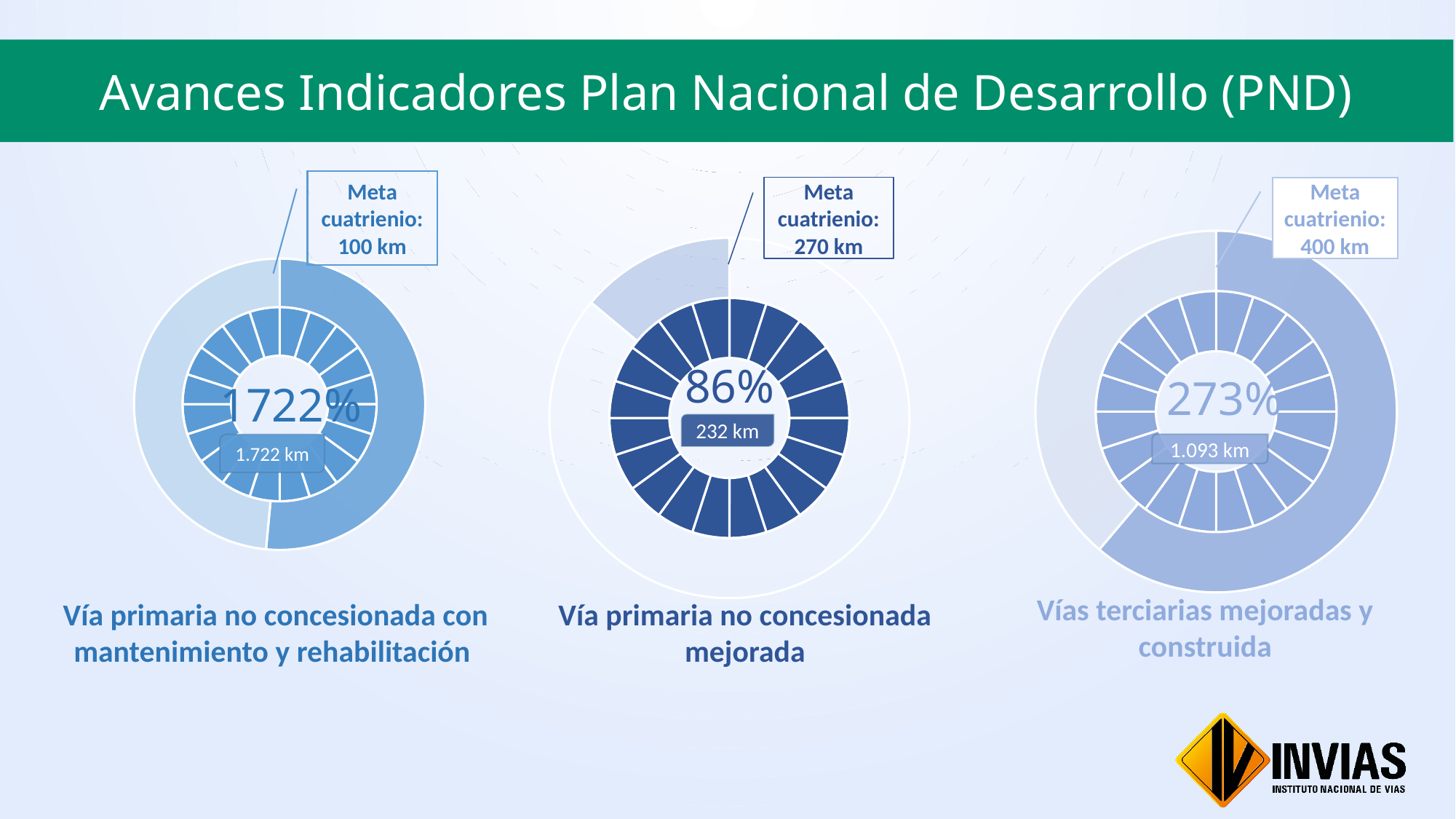
Which of the three indicators has the highest percentage of progress? Vía primaria no concesionada con mantenimiento y rehabilitación What percentage is shown in the centre of the chart for 'Vías terciarias mejoradas y construida'? 273% What is the title of the slide? Avances Indicadores Plan Nacional de Desarrollo (PND) What percentage is shown in the centre of the chart for 'Vía primaria no concesionada mejorada'? 86% What is the 'Meta cuatrienio' for 'Vía primaria no concesionada con mantenimiento y rehabilitación'? 100 km How many km are shown for 'Vías terciarias mejoradas y construida'? 1.093 km What percentage is shown in the centre of the chart for 'Vía primaria no concesionada con mantenimiento y rehabilitación'? 1722% Which of the three indicators has the lowest percentage of progress? Vía primaria no concesionada mejorada For 'Vía primaria no concesionada mejorada', how many km short of the 'Meta cuatrienio' of 270 km is the achieved 232 km? 38 km How many gauge charts are shown on the slide? 3 How many km are shown for 'Vía primaria no concesionada mejorada'? 232 km What is the 'Meta cuatrienio' for 'Vías terciarias mejoradas y construida'? 400 km